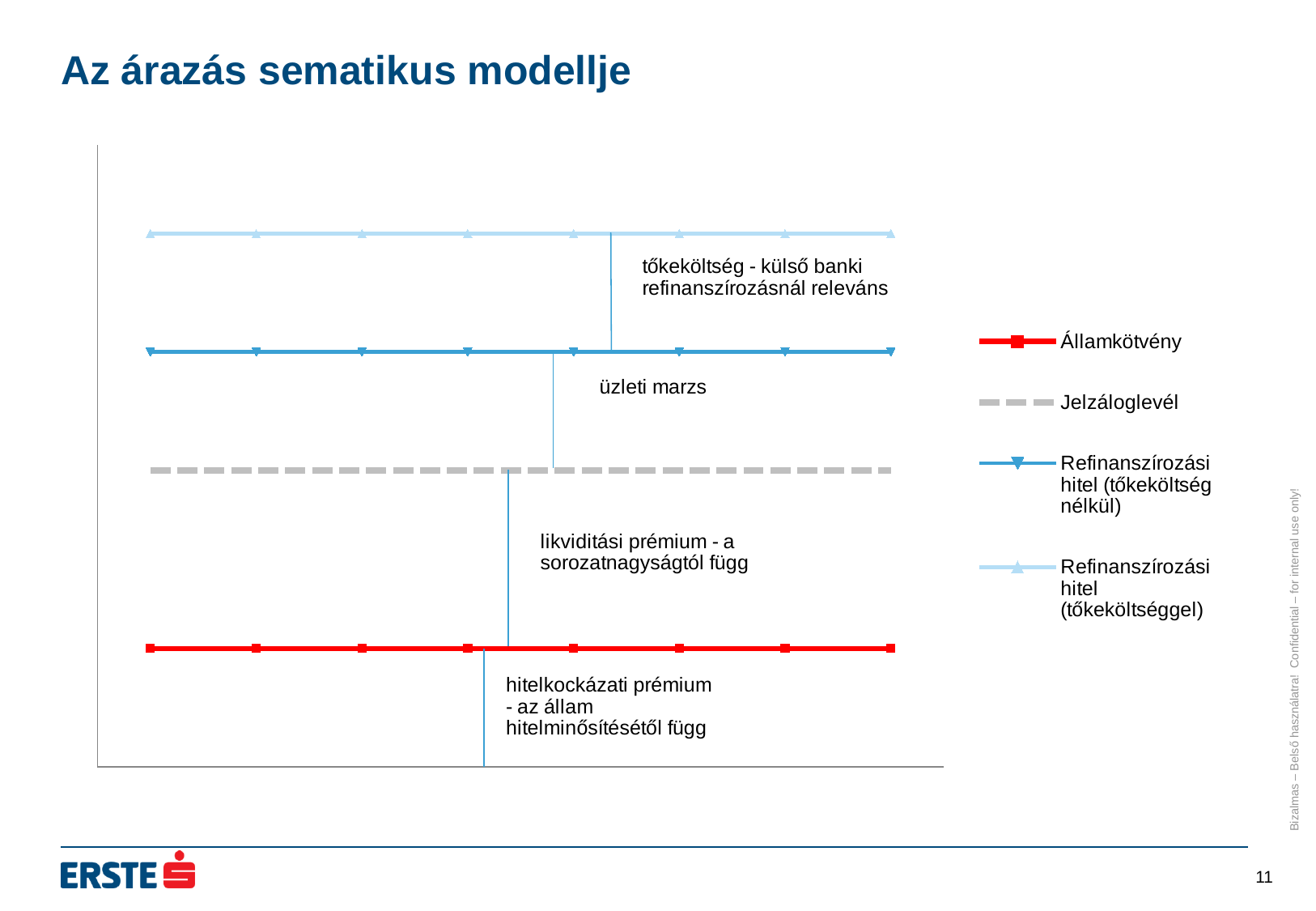
What kind of chart is shown on the slide? line chart Which is plotted higher, Jelzáloglevél or Államkötvény? Jelzáloglevél What colour is the Államkötvény line? red How many series does the legend list? 4 Do the values of the Refinanszírozási hitel (tőkeköltséggel) series rise, fall or stay flat along the x axis? stay flat Which series is plotted highest on the chart? Refinanszírozási hitel (tőkeköltséggel) Which is plotted higher, Refinanszírozási hitel (tőkeköltség nélkül) or Jelzáloglevél? Refinanszírozási hitel (tőkeköltség nélkül) Which series is plotted lowest on the chart? Államkötvény How many data points are marked on the Államkötvény line? 8 Which series is drawn as a grey dashed line? Jelzáloglevél Do the values of the Államkötvény series rise, fall or stay flat along the x axis? stay flat